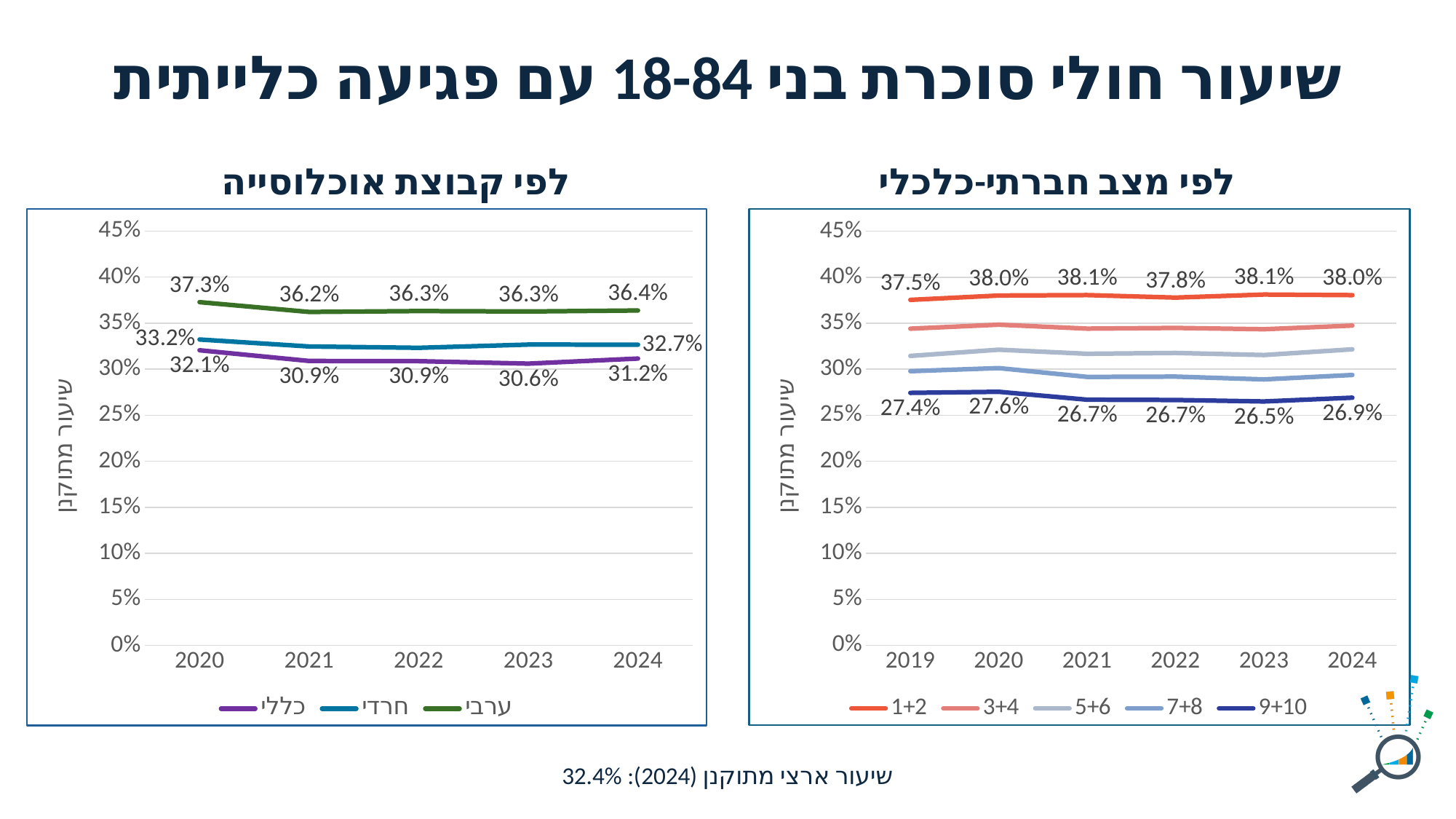
In the left chart (לפי קבוצת אוכלוסייה), what is the difference between the ערבי and כללי values in 2020? 5.2% In the right chart (לפי מצב חברתי-כלכלי), how many years are shown on the x axis? 6 In the left chart (לפי קבוצת אוכלוסייה), which series has the highest value in 2024? ערבי What kind of chart is the right chart (לפי מצב חברתי-כלכלי)? line chart In the right chart (לפי מצב חברתי-כלכלי), what is the value for 9+10 in 2019? 27.4% In the left chart (לפי קבוצת אוכלוסייה), what is the value for חרדי in 2024? 32.7% In the left chart (לפי קבוצת אוכלוסייה), what is the value for ערבי in 2020? 37.3% In the right chart (לפי מצב חברתי-כלכלי), is the value for 5+6 in 2020 greater or less than 30%? greater In the right chart (לפי מצב חברתי-כלכלי), what is the value for 1+2 in 2022? 37.8% In the left chart (לפי קבוצת אוכלוסייה), what is the value for כללי in 2023? 30.6% In the right chart (לפי מצב חברתי-כלכלי), which series has the lowest value in 2024? 9+10 In the left chart (לפי קבוצת אוכלוסייה), how many series does the legend list? 3